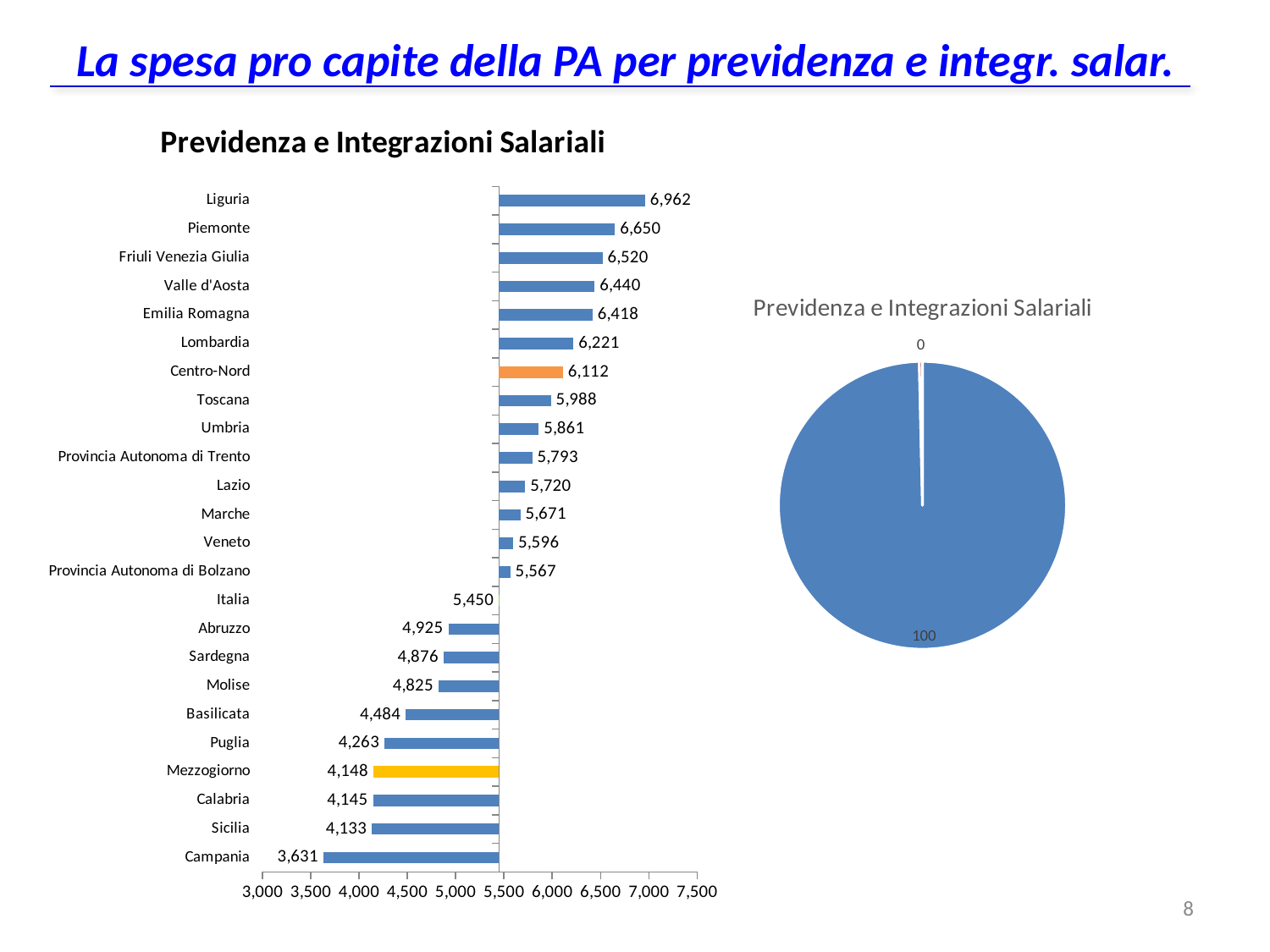
In the bar chart on the left, what is the difference between the values for Centro-Nord and Mezzogiorno? 1,964 In the bar chart on the left, which is larger, the value for Toscana or the value for Lazio? Toscana In the bar chart on the left, what is the value for Campania? 3,631 In the bar chart on the left, is the value for Italia greater or less than 5,000? greater In the bar chart on the left, what is the value for Liguria? 6,962 In the bar chart on the left, what is the value for Centro-Nord? 6,112 What is the title of the chart on the right of the slide? Previdenza e Integrazioni Salariali In the bar chart on the left, what is the value for Mezzogiorno? 4,148 What kind of chart is the chart on the left of the slide? bar chart In the bar chart on the left, which category has the highest value? Liguria In the bar chart on the left, which category has the lowest value? Campania How many categories are shown in the bar chart on the left? 24